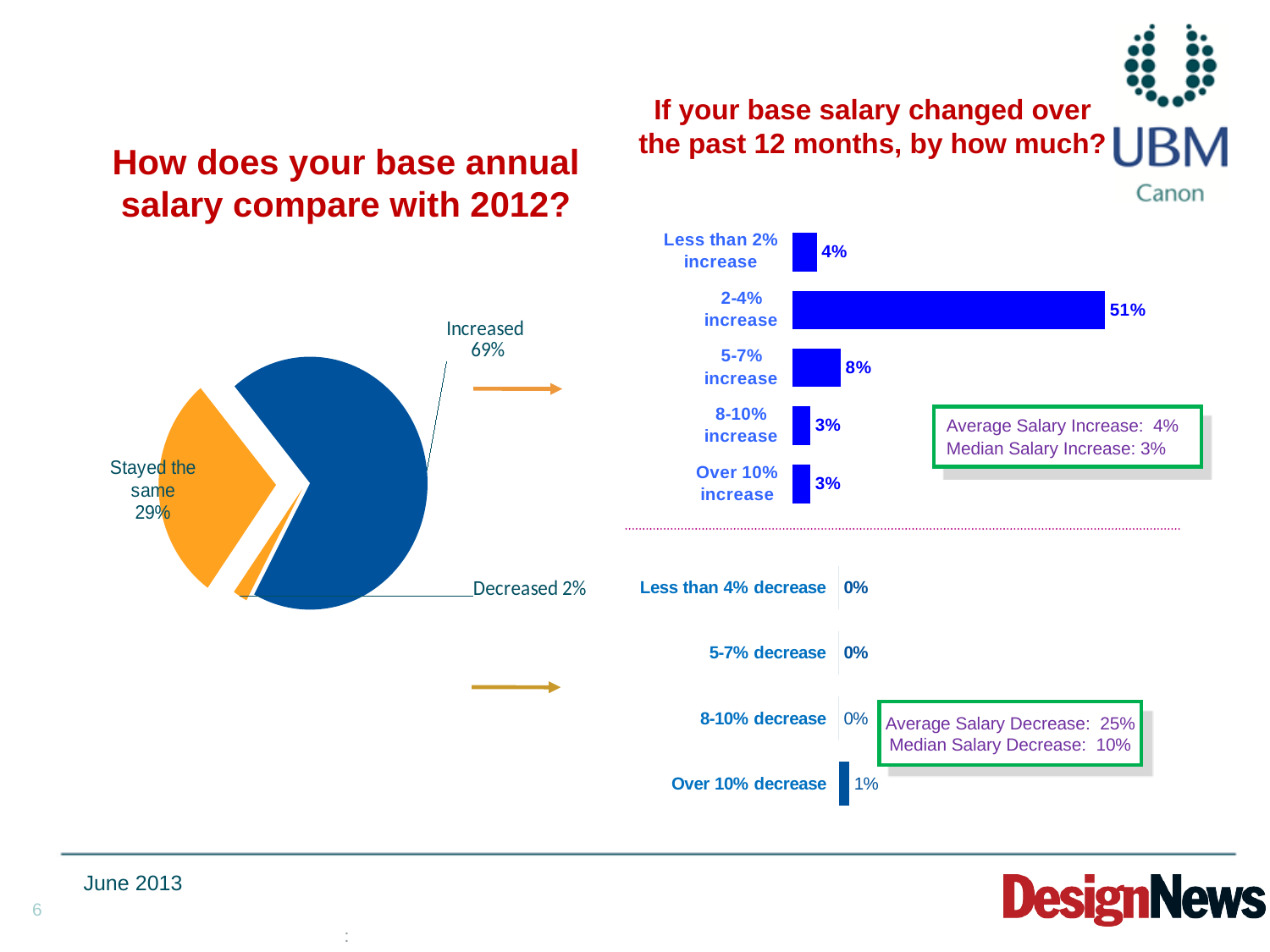
In the bar chart 'If your base salary changed over the past 12 months, by how much?', what is the value for '5-7% increase'? 8% In the bar chart 'If your base salary changed over the past 12 months, by how much?', which is larger: 'Less than 2% increase' or '5-7% increase'? 5-7% increase In the pie chart 'How does your base annual salary compare with 2012?', what share of respondents said their salary increased? 69% In the pie chart 'How does your base annual salary compare with 2012?', which category has the smallest slice? Decreased In the bar chart 'If your base salary changed over the past 12 months, by how much?', what is the value for '2-4% increase'? 51% In the bar chart 'If your base salary changed over the past 12 months, by how much?', which increase category has the highest value? 2-4% increase What type of chart is used for 'How does your base annual salary compare with 2012?'? Pie chart How many slices does the pie chart 'How does your base annual salary compare with 2012?' have? 3 In the bar chart 'If your base salary changed over the past 12 months, by how much?', what is the value for 'Over 10% decrease'? 1% In the pie chart 'How does your base annual salary compare with 2012?', what share of respondents said their salary stayed the same? 29% What type of chart is used for 'If your base salary changed over the past 12 months, by how much?'? Bar chart In the pie chart 'How does your base annual salary compare with 2012?', what is the difference between the 'Increased' and 'Stayed the same' shares? 40%